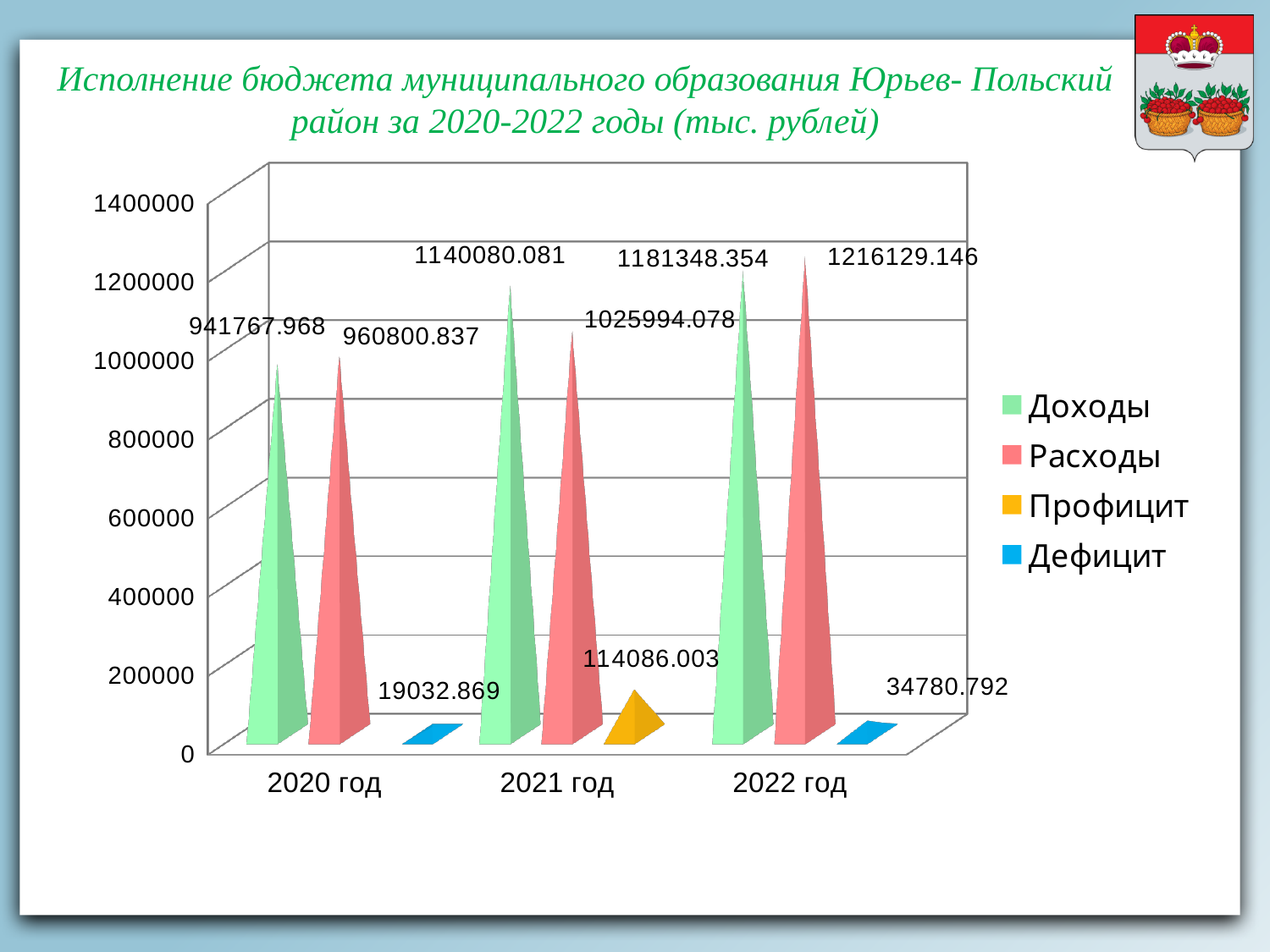
In which year is Доходы the highest? 2022 год How many years are shown on the x axis? 3 What is the value of Доходы for 2020 год? 941767.968 For 2021 год, which is larger: Доходы or Расходы? Доходы In which year is Расходы the lowest? 2020 год Does Доходы rise or fall from 2020 год to 2022 год? rise What is the difference between Расходы and Доходы for 2022 год? 34780.792 What is the value of Профицит for 2021 год? 114086.003 Which colour represents Дефицит in the legend? blue What is the value of Дефицит for 2020 год? 19032.869 How many series does the legend list? 4 What is the value of Расходы for 2022 год? 1216129.146